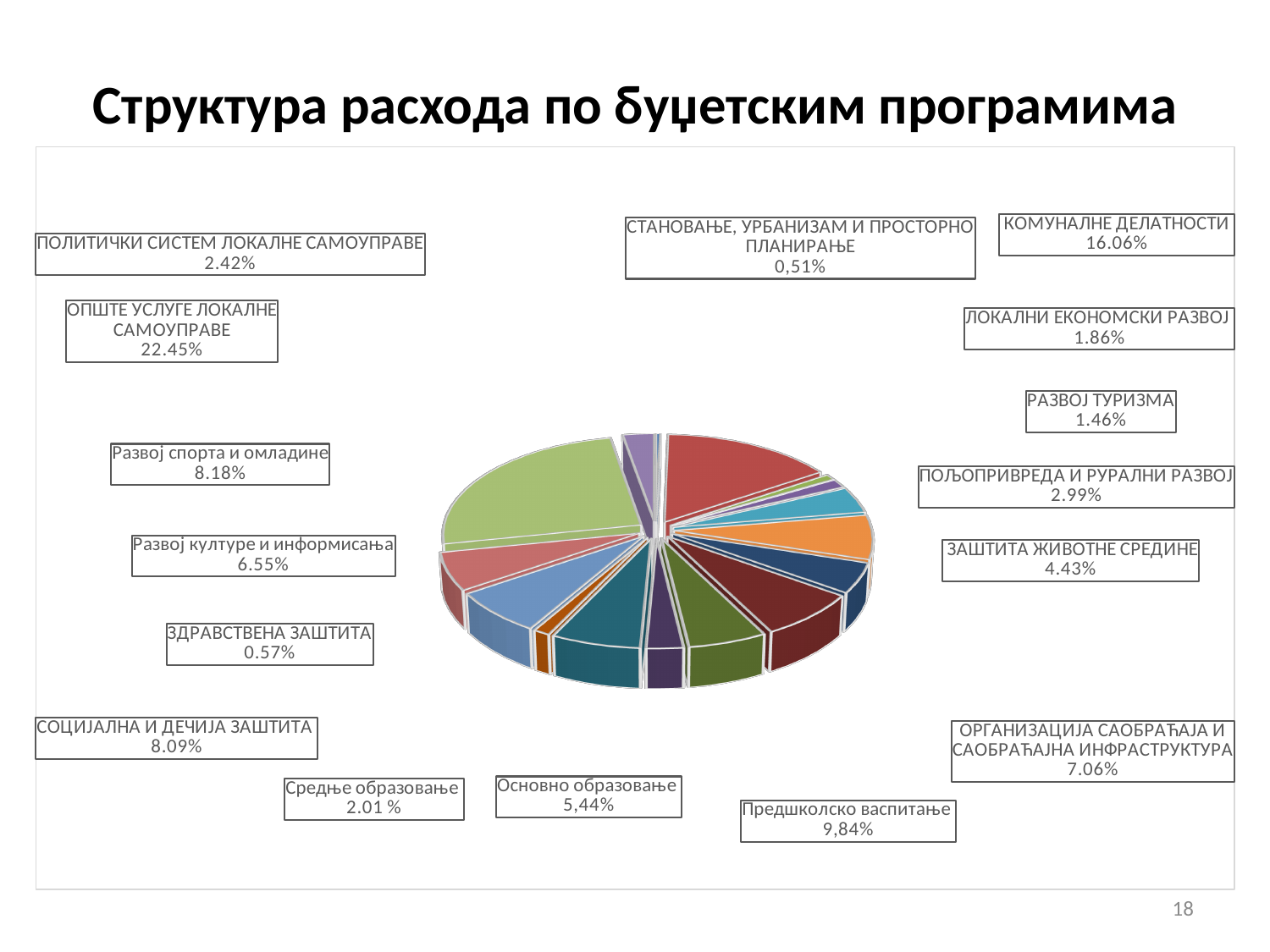
What is the difference in percentage points between КОМУНАЛНЕ ДЕЛАТНОСТИ and ОРГАНИЗАЦИЈА САОБРАЋАЈА И САОБРАЋАЈНА ИНФРАСТРУКТУРА? 9.00% Which has a larger share, Развој културе и информисања or ЗАШТИТА ЖИВОТНЕ СРЕДИНЕ? Развој културе и информисања What is the difference in percentage points between ОПШТЕ УСЛУГЕ ЛОКАЛНЕ САМОУПРАВЕ and КОМУНАЛНЕ ДЕЛАТНОСТИ? 6.39% What share does КОМУНАЛНЕ ДЕЛАТНОСТИ have in the pie chart? 16.06% What share does ЗДРАВСТВЕНА ЗАШТИТА have in the pie chart? 0.57% What share does Предшколско васпитање have in the pie chart? 9,84% What share does ОПШТЕ УСЛУГЕ ЛОКАЛНЕ САМОУПРАВЕ have in the pie chart? 22.45% How many budget programs (slices) are shown in the pie chart? 16 What is the title of the chart? Структура расхода по буџетским програмима Which program has the smallest share of expenditure in the pie chart? СТАНОВАЊЕ, УРБАНИЗАМ И ПРОСТОРНО ПЛАНИРАЊЕ What kind of chart is shown on the slide? pie chart Which program has the largest share of expenditure in the pie chart? ОПШТЕ УСЛУГЕ ЛОКАЛНЕ САМОУПРАВЕ